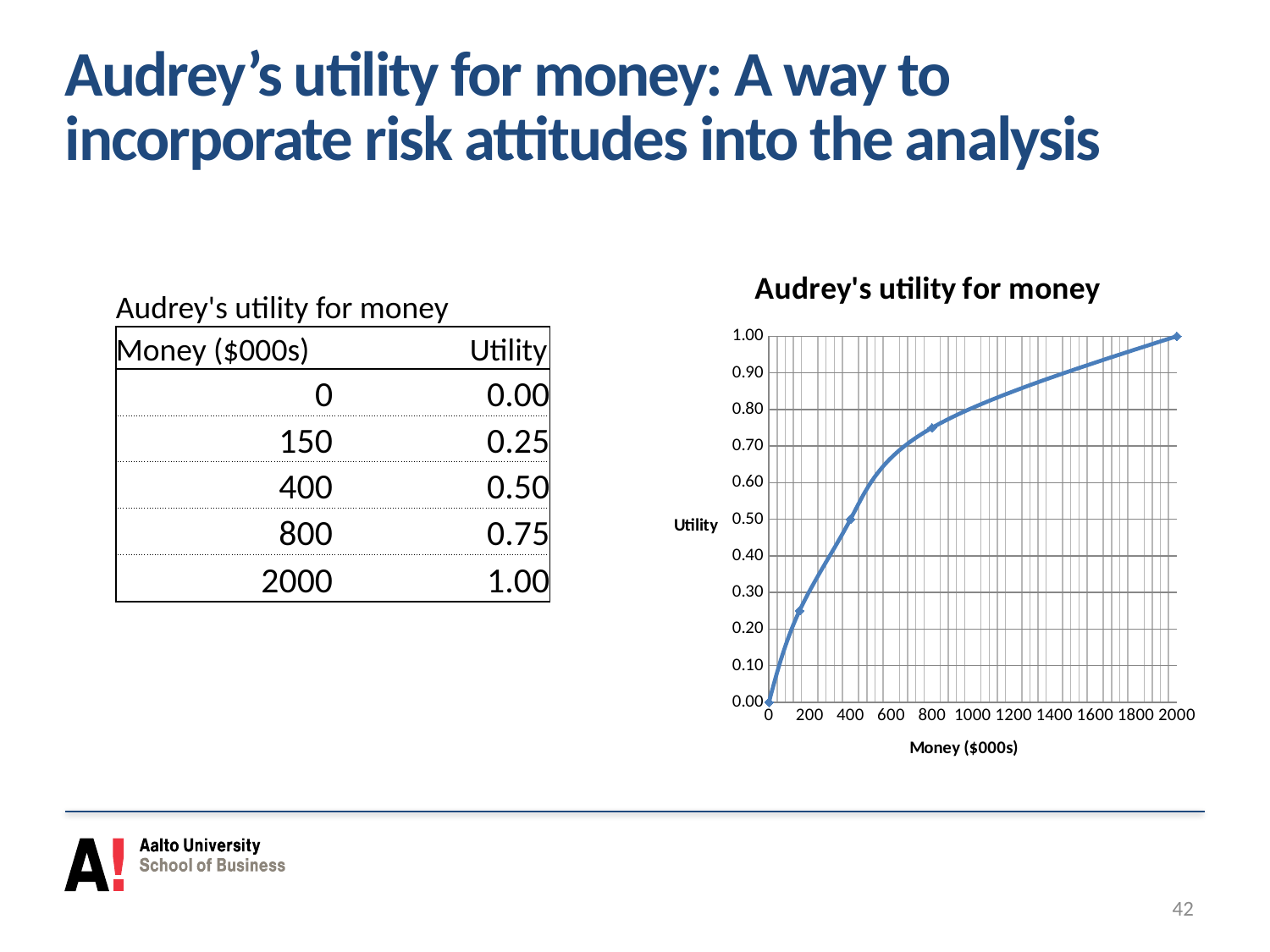
What is the utility value at money of 400 ($000s)? 0.50 What is the difference in utility between money of 800 and money of 150 ($000s)? 0.50 At which money value is utility highest? 2000 What is the title of the chart? Audrey's utility for money What is the utility value at money of 800 ($000s)? 0.75 What kind of chart is shown on the slide? line chart How many data points are plotted on the chart? 5 What is the label of the x axis of the chart? Money ($000s) What is the utility value at money of 2000 ($000s)? 1.00 At which money value is utility lowest? 0 Does utility rise or fall as money increases along the x axis? rise What is the utility value at money of 150 ($000s)? 0.25